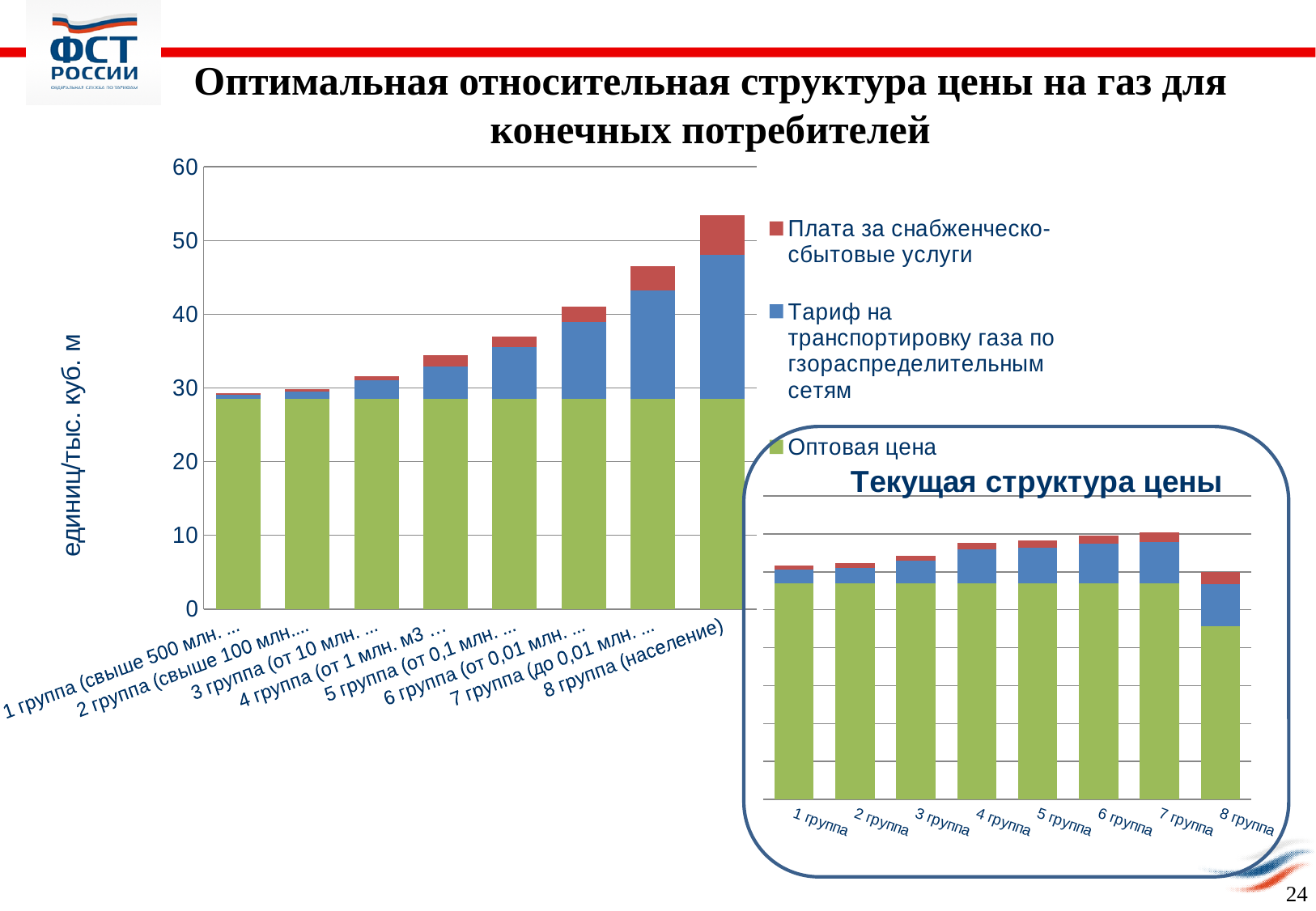
In the main chart, is the total for 7 группа greater or less than 40? greater What is the title of the inset chart in the lower right? Текущая структура цены In the main chart, is the total for 8 группа (население) greater or less than 50? greater What kind of chart is the main chart titled "Оптимальная относительная структура цены на газ для конечных потребителей"? Stacked bar chart In the main chart, how many consumer groups are shown on the x axis? 8 In the main chart, which legend entry is shown in green? Оптовая цена In the main chart, how many series does the legend list? 3 In the main chart, do the total bar heights rise or fall from 1 группа to 8 группа? rise In the main chart, which is larger, the total for 7 группа or the total for 3 группа? 7 группа In the inset chart "Текущая структура цены", which group has the smallest green (Оптовая цена) segment? 8 группа In the main chart, is the total for 4 группа greater or less than 40? less In the main chart, which group has the highest total bar? 8 группа (население)